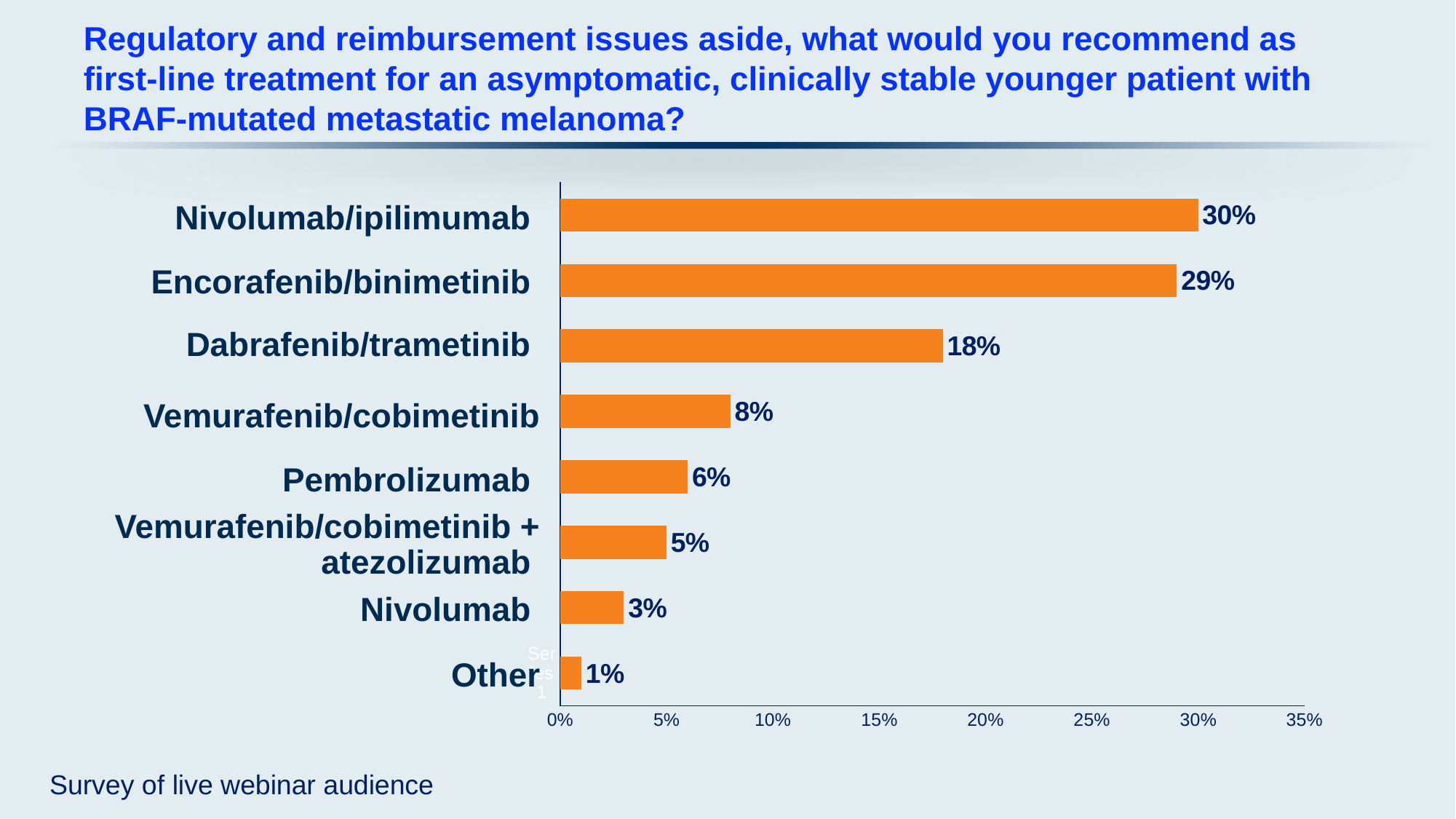
What type of chart is shown on the slide? Bar chart Is the value for Vemurafenib/cobimetinib greater or less than 10%? less What percentage of respondents recommended Dabrafenib/trametinib? 18% What percentage of respondents recommended Nivolumab/ipilimumab? 30% What percentage of respondents chose Other? 1% What percentage of respondents recommended Vemurafenib/cobimetinib + atezolizumab? 5% How many treatment options are shown in the chart? 8 Which category received the lowest percentage? Other Which received a higher percentage, Pembrolizumab or Nivolumab? Pembrolizumab Which treatment option received the highest percentage of recommendations? Nivolumab/ipilimumab What is the difference in percentage points between Encorafenib/binimetinib and Dabrafenib/trametinib? 11 What is the maximum value shown on the horizontal axis? 35%